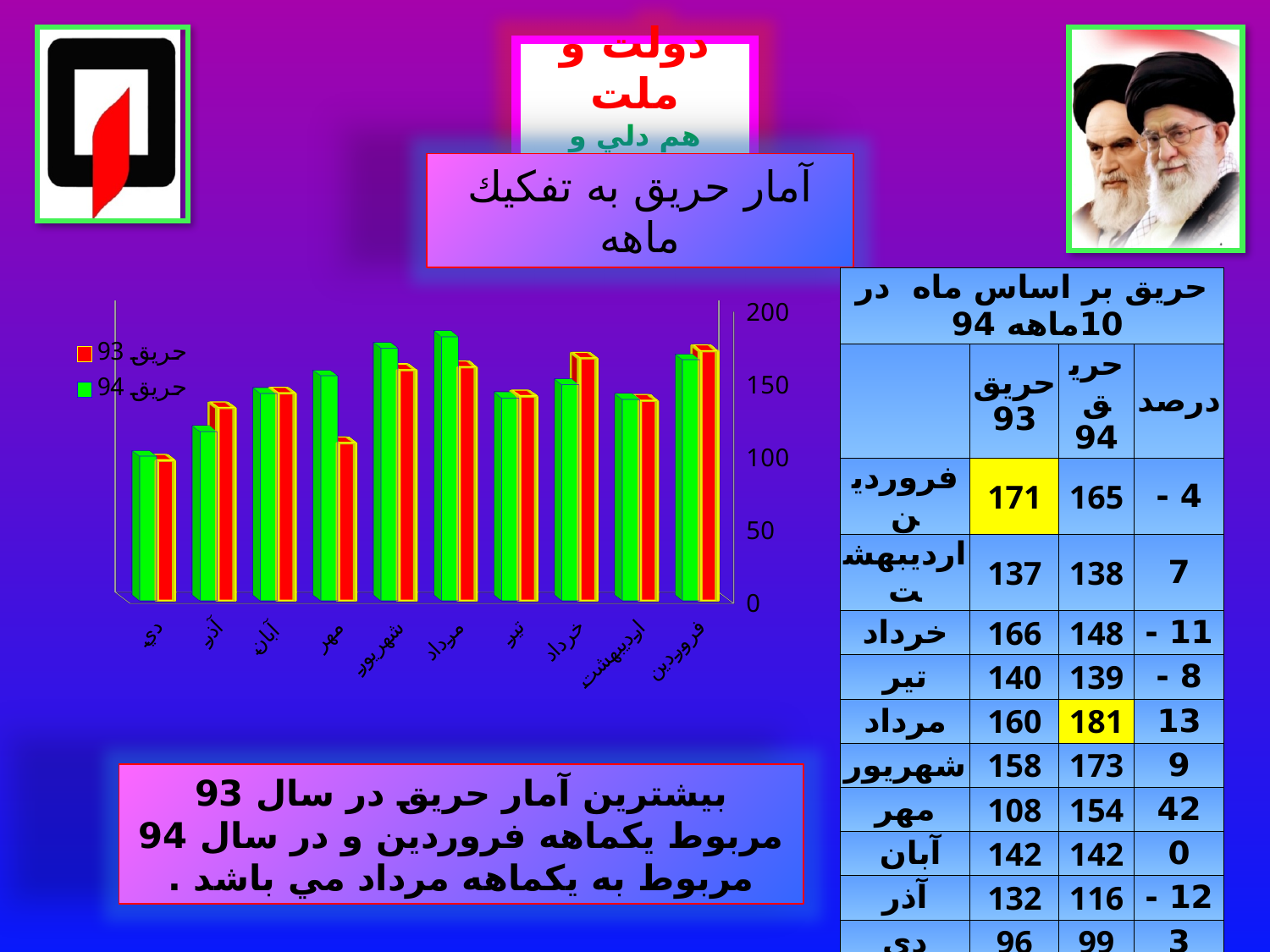
Which month has the highest value for the حريق 93 series? فروردين Which month has the lowest value for the حريق 94 series? دي How many series does the chart legend list? 2 Is the value for مرداد in the حريق 94 series greater or less than 150? greater How many month categories are plotted on the x axis of the chart? 10 Which colour represents the حريق 93 series in the chart? red Which month has the highest value for the حريق 94 series? مرداد For مهر, which series has the larger value, حريق 93 or حريق 94? حريق 94 Which colour represents the حريق 94 series in the chart? green For آذر, which series has the larger value, حريق 93 or حريق 94? حريق 93 What kind of chart is shown on the slide? bar chart Is the value for مهر in the حريق 93 series greater or less than 150? less